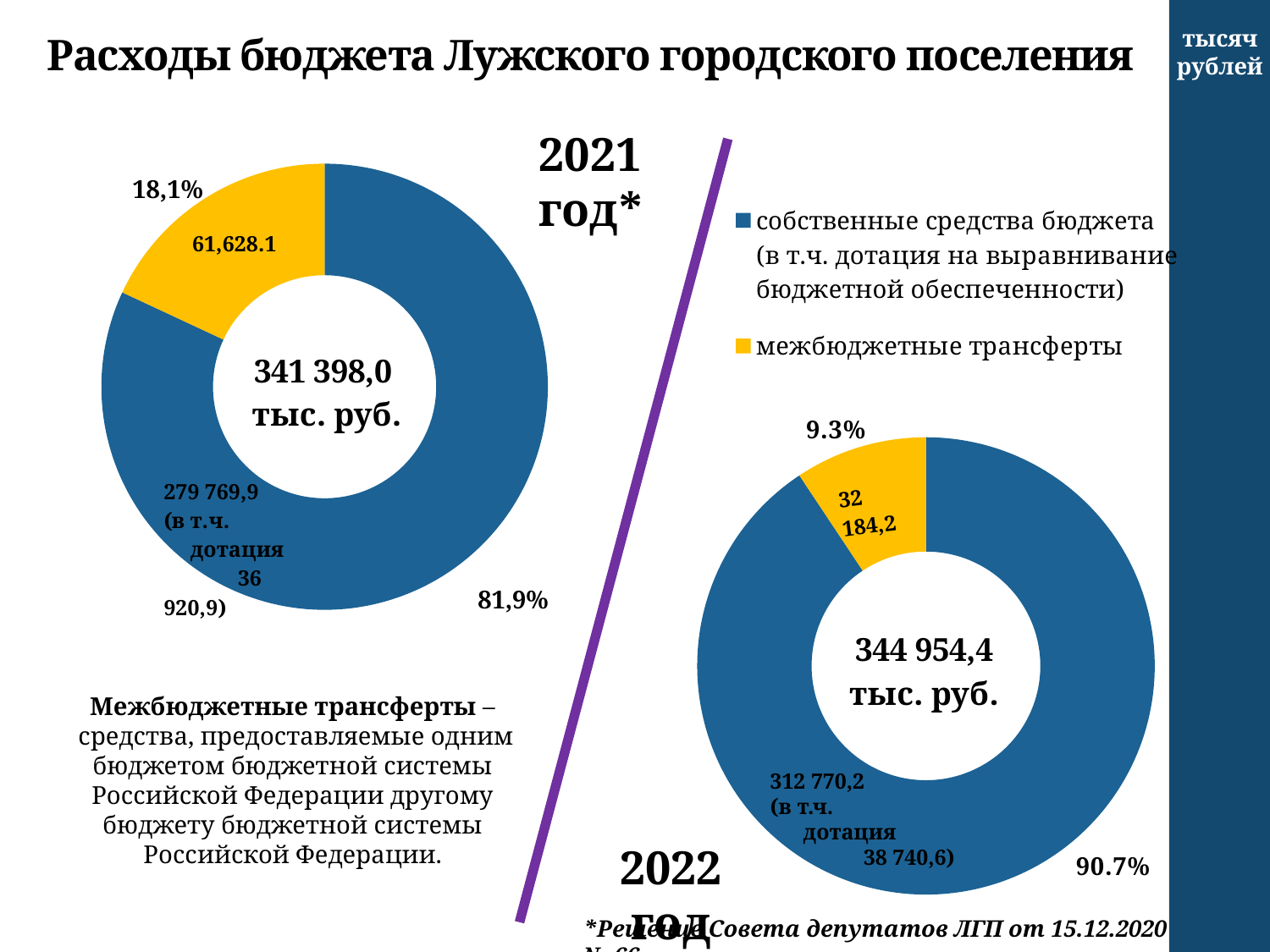
What total is printed in the centre of the 2021 chart? 341 398,0 тыс. руб. On the 2021 chart, what percentage share is shown for межбюджетные трансферты? 18,1% How many series does the legend list? 2 On the 2022 chart, what value is shown for собственные средства бюджета? 312 770,2 On the 2021 chart, what value is shown for межбюджетные трансферты? 61,628.1 On the 2022 chart, which category has the largest share? собственные средства бюджета What total is printed in the centre of the 2022 chart? 344 954,4 тыс. руб. On the 2021 chart, what percentage share is shown for собственные средства бюджета? 81,9% What kind of chart is used on this slide? Pie (doughnut) chart On the 2022 chart, what percentage share is shown for собственные средства бюджета? 90.7% On the 2021 chart, which category has the smallest share? межбюджетные трансферты On the 2022 chart, what value is shown for межбюджетные трансферты? 32 184,2